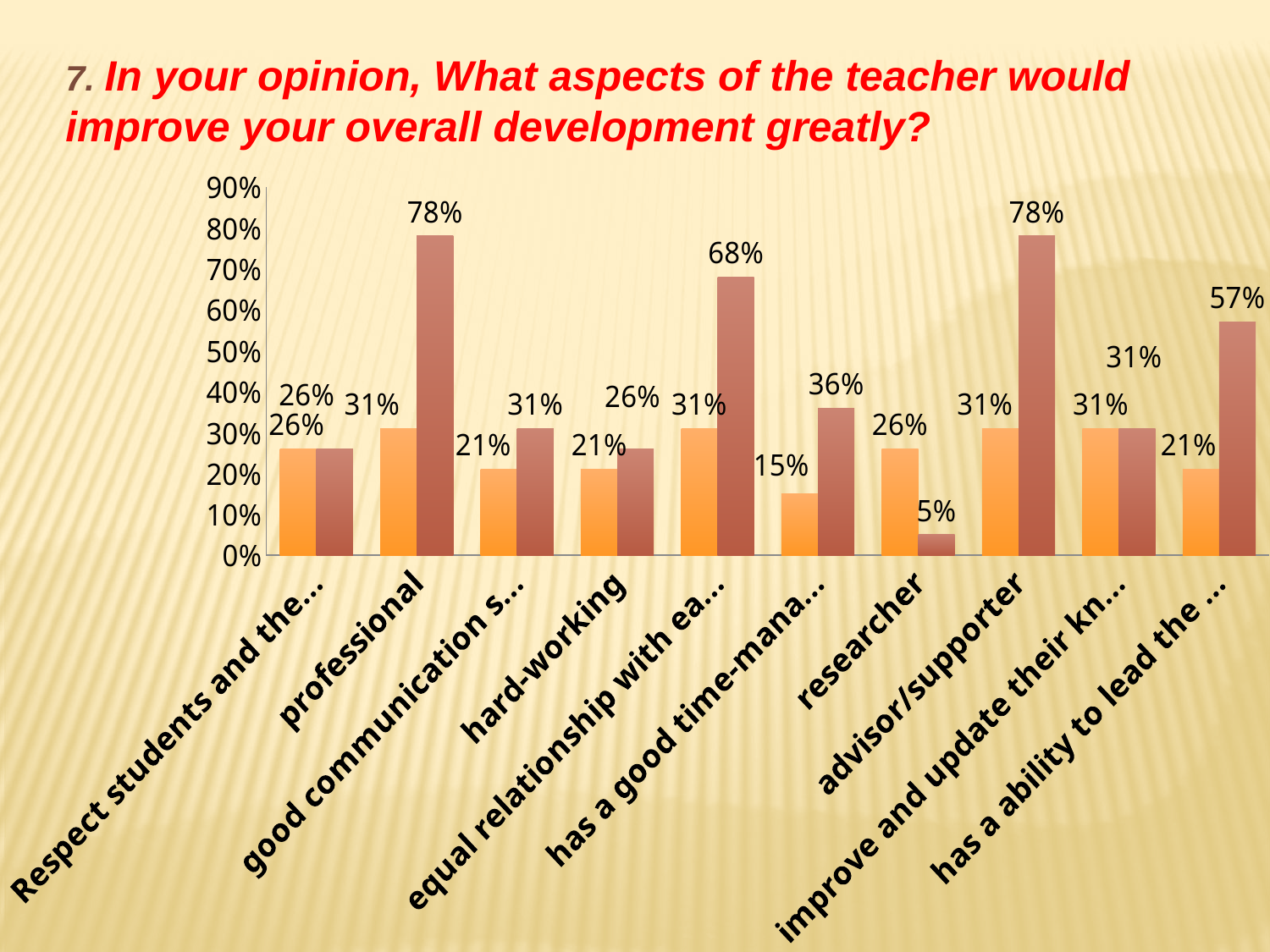
What kind of chart is shown on the slide? bar chart For 'researcher', which bar is larger, the orange bar or the brown bar? the orange bar What is the difference between the brown bar and the orange bar for 'equal relationship with ea...'? 37% What is the value of the orange bar for 'researcher'? 26% What is the value of the brown bar for 'has a ability to lead the ...'? 57% What is the difference between the brown bar for 'has a good time-mana...' and the brown bar for 'researcher'? 31% How many categories are shown along the x axis of the chart? 10 What is the value of the brown bar for 'professional'? 78% Is the brown bar for 'advisor/supporter' greater or less than 70%? greater Which category has the lowest brown bar? researcher What is the value of the brown bar for 'hard-working'? 26% Which category has the lowest orange bar? has a good time-mana...